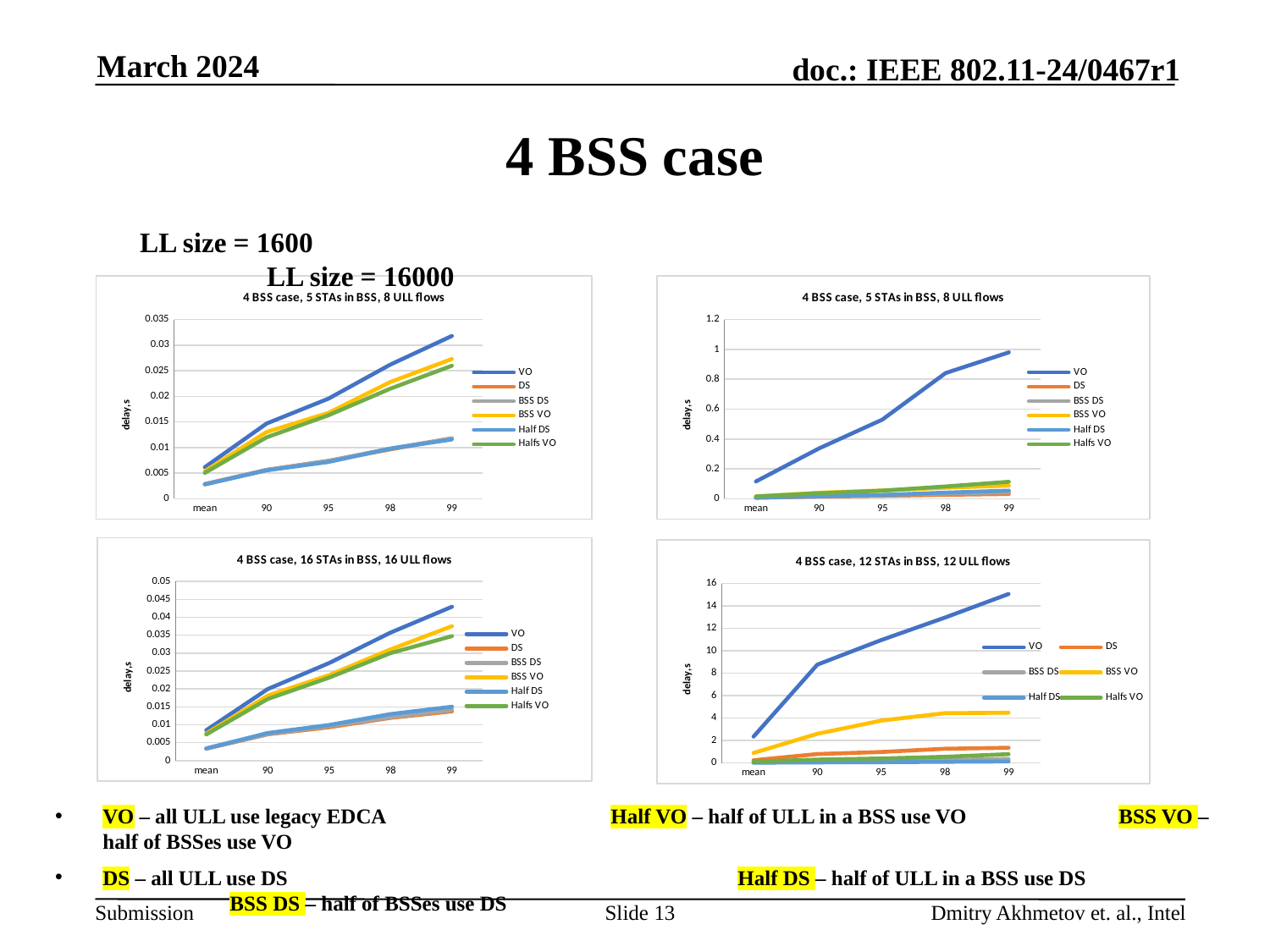
In the bottom-right chart (4 BSS case, 12 STAs in BSS, 12 ULL flows), is the VO value at 99 greater or less than 14? greater In the bottom-right chart (4 BSS case, 12 STAs in BSS, 12 ULL flows), which series has the highest value at 99? VO In the top-right chart, is the VO value at 99 greater or less than 0.8? greater In the top-right chart, which is larger at 99: VO or DS? VO How many series does the legend of the top-left chart list? 6 In the top-left chart, is the VO value at 99 greater or less than 0.03? greater In the bottom-right chart (4 BSS case, 12 STAs in BSS, 12 ULL flows), does the VO series rise or fall from mean to 99? rise What is the y-axis label of the top-left chart? delay,s How many points are plotted along the x axis of the bottom-right chart (4 BSS case, 12 STAs in BSS, 12 ULL flows)? 5 What kind of chart is the top-left chart on the slide? line chart What is the title of the bottom-left chart? 4 BSS case, 16 STAs in BSS, 16 ULL flows